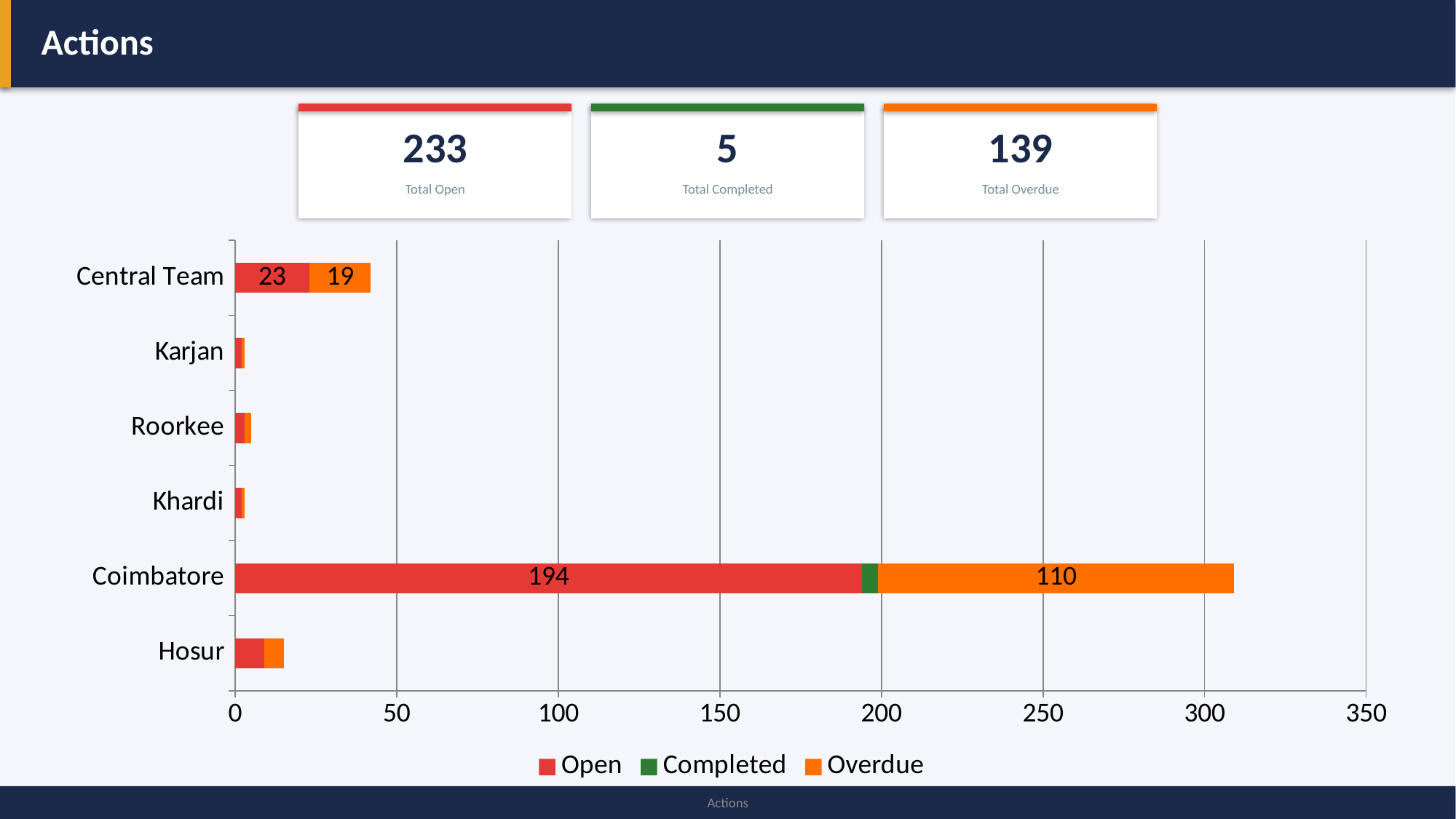
Is the total length of the Hosur bar greater or less than 50? less How many categories are shown on the chart? 6 Is the total length of the Coimbatore bar greater or less than 250? greater How many series does the legend list? 3 What is the Open value for Central Team? 23 Which category has the longest bar overall? Coimbatore What is the Overdue value for Coimbatore? 110 Which is larger for Central Team, the Open value or the Overdue value? Open What is the Open value for Coimbatore? 194 What is the difference between the Open values for Coimbatore and Central Team? 171 What is the difference between the Open and Overdue values for Coimbatore? 84 What is the Overdue value for Central Team? 19